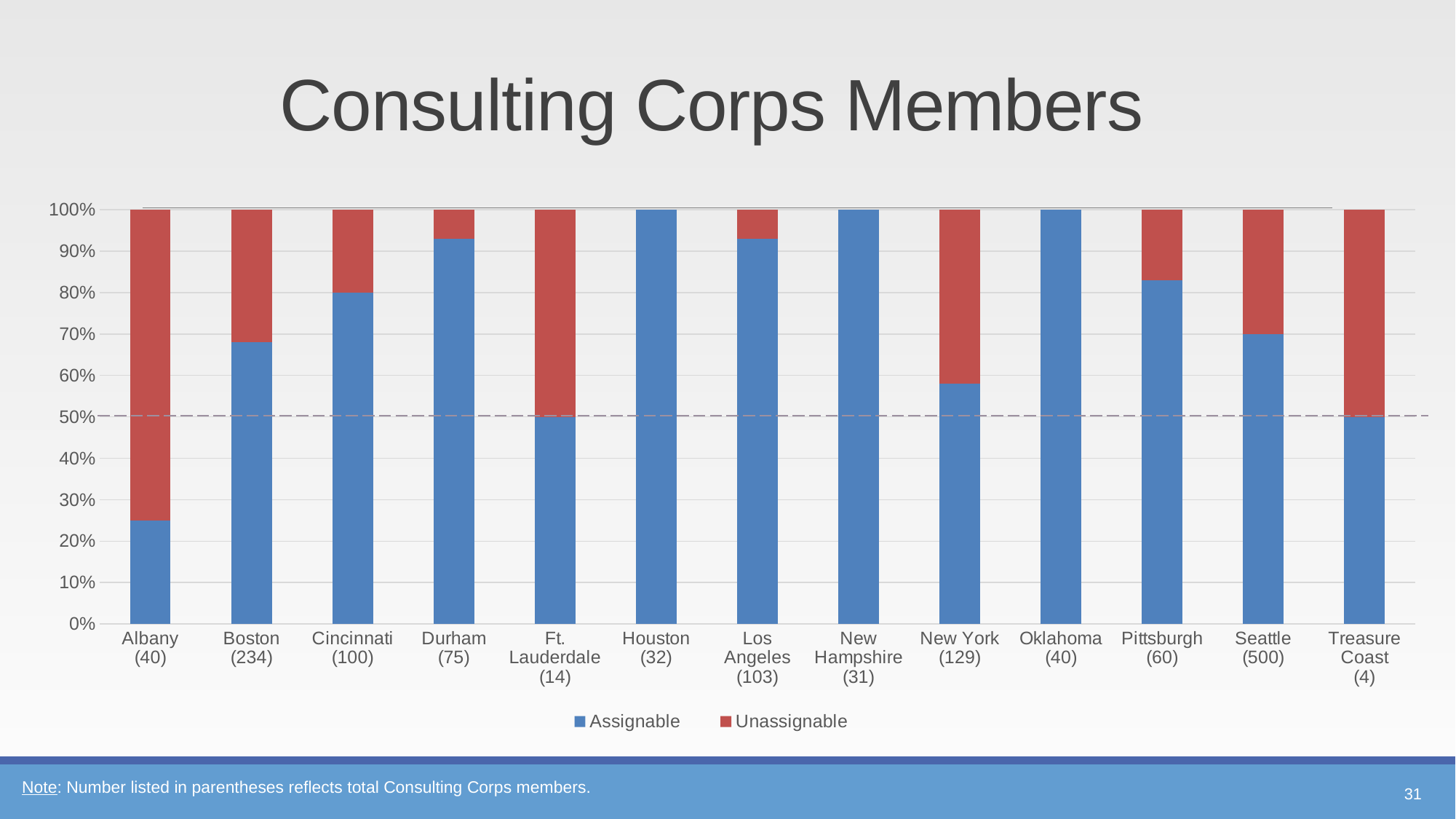
Is the Assignable share for Durham (75) greater or less than 90%? greater Which location has the lowest Assignable share? Albany (40) What is the Assignable share for Cincinnati (100)? 80% What is the Assignable share for Houston (32)? 100% What kind of chart is shown on the slide? Stacked bar chart What are the two series named in the legend? Assignable and Unassignable How many series does the legend list? 2 What is the Assignable share for Ft. Lauderdale (14)? 50% How many locations are shown along the x axis? 13 Which location has the largest Unassignable share? Albany (40) Which has the larger Assignable share, Boston (234) or New York (129)? Boston (234) Is the Assignable share for New York (129) greater or less than 60%? less